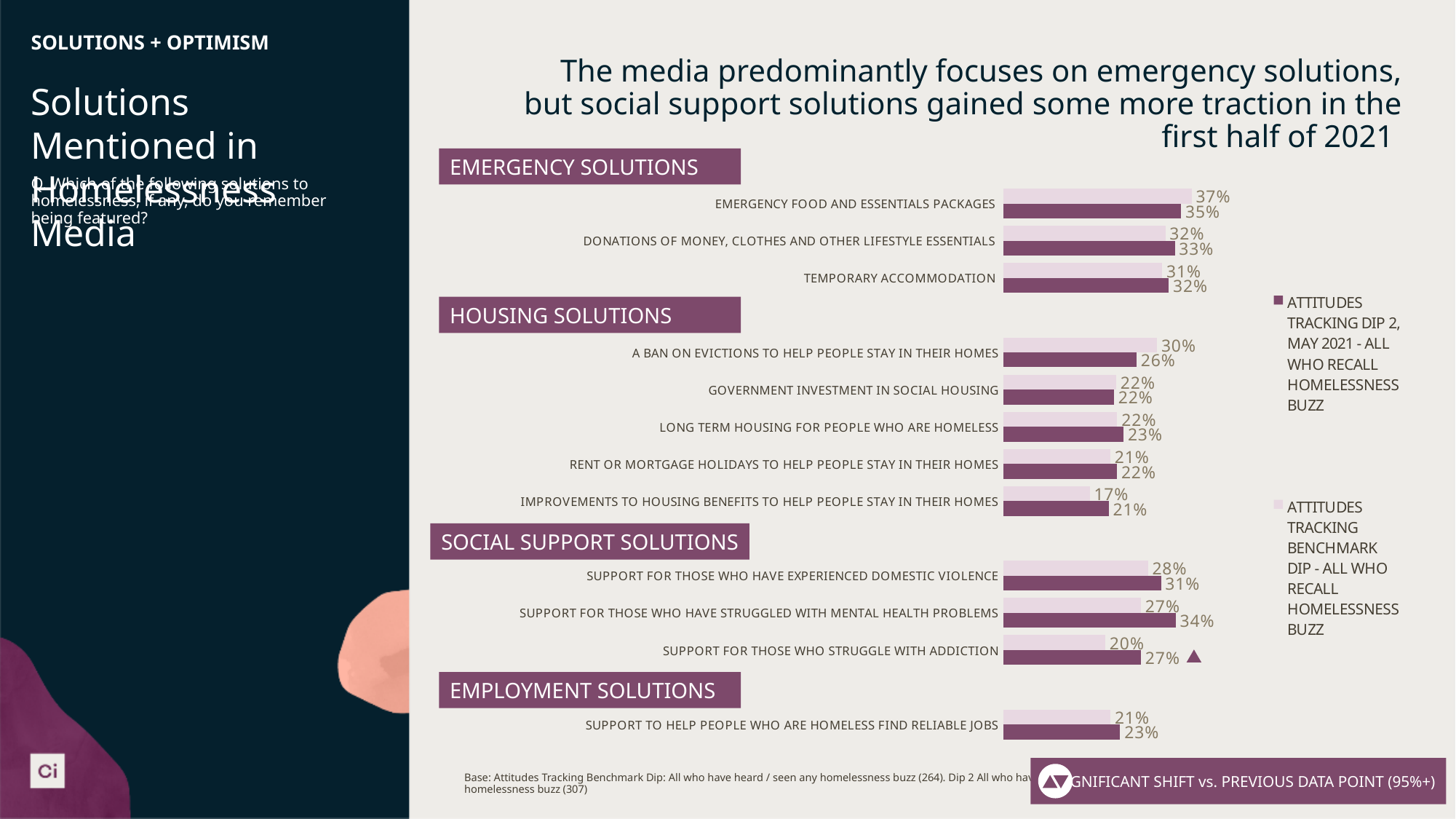
Which category has the lowest Attitudes Tracking Benchmark Dip value? Improvements to housing benefits to help people stay in their homes Which category has the highest Attitudes Tracking Benchmark Dip value? Emergency food and essentials packages How many series does the chart legend list? 2 What kind of chart is shown on the slide? bar chart For A ban on evictions to help people stay in their homes, which series has the larger value: Attitudes Tracking Dip 2, May 2021 or Attitudes Tracking Benchmark Dip? Attitudes Tracking Benchmark Dip What is the Attitudes Tracking Benchmark Dip value for Support for those who struggle with addiction? 20% How many solution categories are plotted in the chart? 12 What is the difference between the Dip 2, May 2021 value and the Benchmark Dip value for Support for those who struggle with addiction? 7% What is the Attitudes Tracking Dip 2, May 2021 value for Emergency food and essentials packages? 35% What is the Attitudes Tracking Dip 2, May 2021 value for Support for those who have struggled with mental health problems? 34% What is the Attitudes Tracking Benchmark Dip value for Emergency food and essentials packages? 37% Which category is marked with a triangle indicating a significant shift vs. the previous data point? Support for those who struggle with addiction